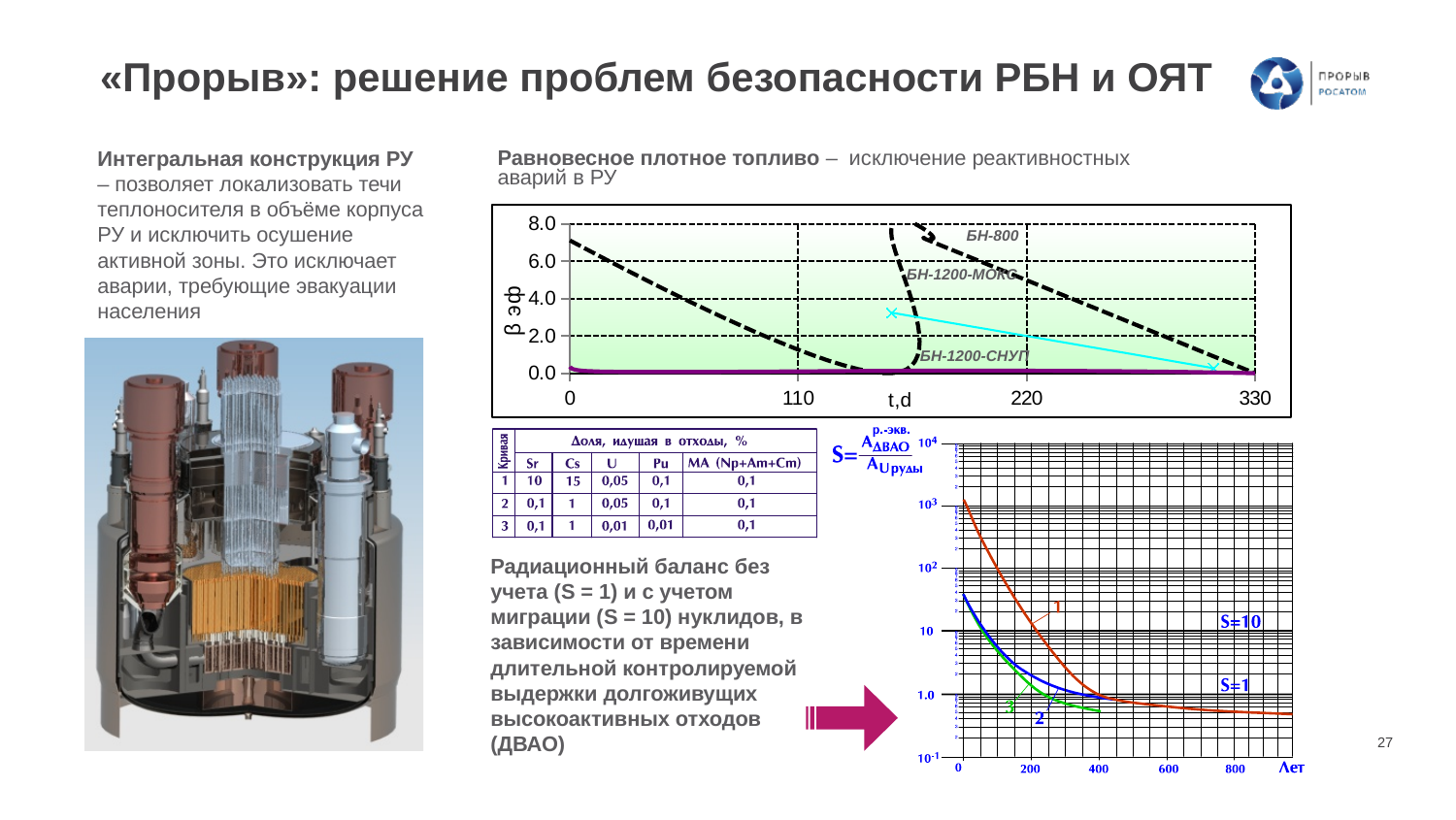
What kind of chart is the bottom-right chart with the x axis labelled Лет? line chart On the top-right chart (β эф vs t,d), is the value for БН-1200-СНУП greater or less than 2.0? less On the top-right chart (β эф vs t,d), do the dashed БН-800 and БН-1200-МОКС curves rise or fall as t increases? fall On the top-right chart (β эф vs t,d), what is the highest value shown on the y axis? 8.0 On the bottom-right chart (x axis Лет), what is the largest tick value on the x axis? 800 On the top-right chart (β эф vs t,d), what is the largest tick value on the x axis? 330 On the bottom-right chart (x axis Лет), which of the two S labels, S=10 or S=1, is placed higher on the chart? S=10 On the bottom-right chart (x axis Лет), how many numbered curves (1, 2, 3) are plotted? 3 On the top-right chart (β эф vs t,d), which labelled curve stays lowest across the whole time range? БН-1200-СНУП On the bottom-right chart (x axis Лет), do the curves rise or fall as the number of years increases? fall What kind of chart is the top-right chart with the x axis labelled t,d? line chart On the top-right chart (β эф vs t,d), how many reactor curves are labelled? 3